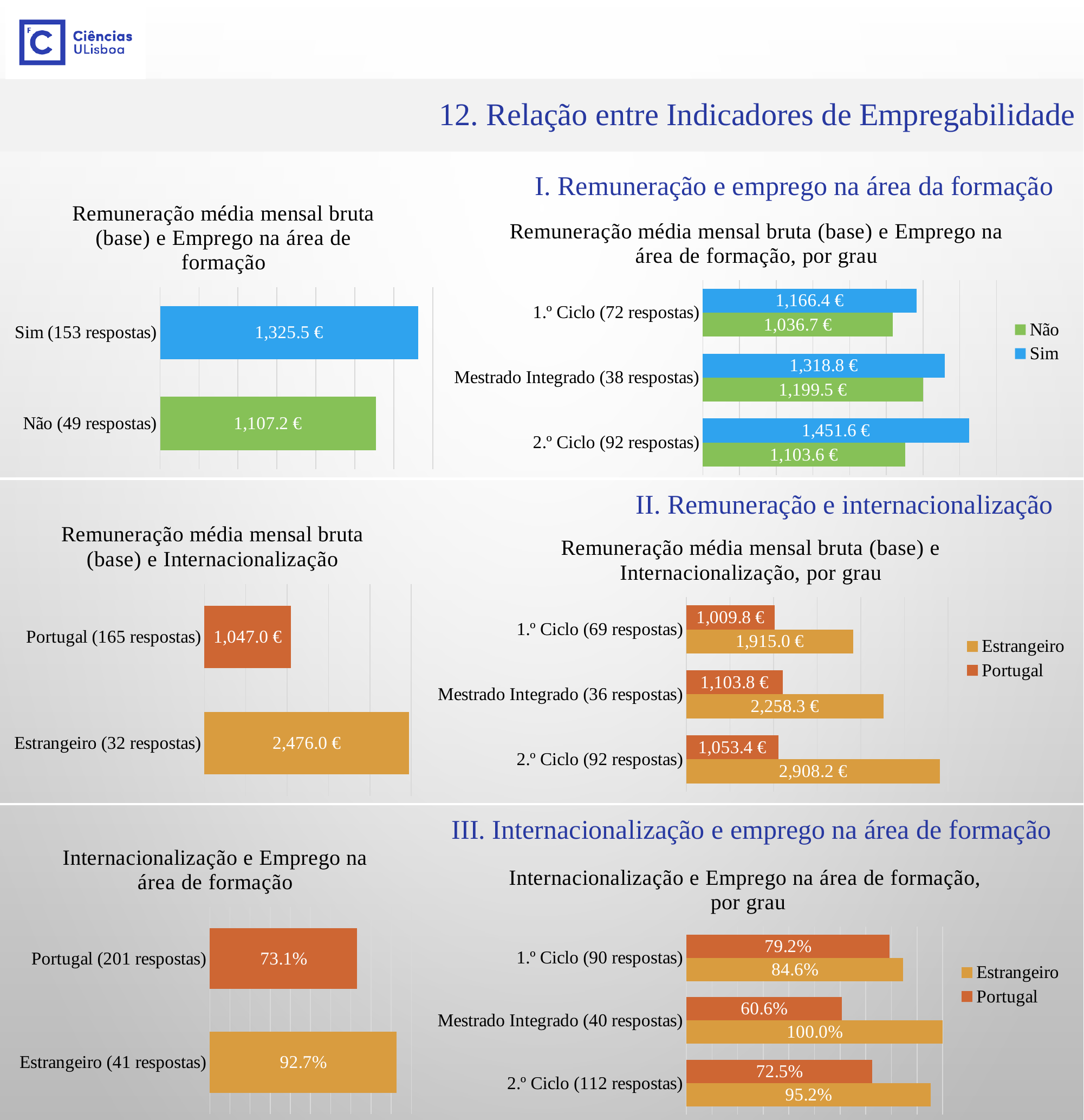
In the top-right chart 'Remuneração média mensal bruta (base) e Emprego na área de formação, por grau', what is the 'Sim' value for '2.º Ciclo (92 respostas)'? 1,451.6 € In the bottom-right chart 'Internacionalização e Emprego na área de formação, por grau', what is the 'Portugal' value for 'Mestrado Integrado (40 respostas)'? 60.6% In the middle-right chart 'Remuneração média mensal bruta (base) e Internacionalização, por grau', what is the 'Estrangeiro' value for 'Mestrado Integrado (36 respostas)'? 2,258.3 € In the bottom-left chart 'Internacionalização e Emprego na área de formação', what is the value for 'Portugal (201 respostas)'? 73.1% In the middle-right chart 'Remuneração média mensal bruta (base) e Internacionalização, por grau', which degree has the highest 'Estrangeiro' value? 2.º Ciclo (92 respostas) In the top-left chart 'Remuneração média mensal bruta (base) e Emprego na área de formação', what is the difference between the 'Sim' and 'Não' values? 218.3 € How many series does the legend list in the top-right chart 'Remuneração média mensal bruta (base) e Emprego na área de formação, por grau'? 2 In the top-left chart 'Remuneração média mensal bruta (base) e Emprego na área de formação', what is the value for 'Sim (153 respostas)'? 1,325.5 € In the middle-left chart 'Remuneração média mensal bruta (base) e Internacionalização', what is the value for 'Estrangeiro (32 respostas)'? 2,476.0 € What type of chart is the bottom-left chart 'Internacionalização e Emprego na área de formação'? Bar chart In the bottom-right chart 'Internacionalização e Emprego na área de formação, por grau', which is larger for '1.º Ciclo (90 respostas)': the 'Estrangeiro' value or the 'Portugal' value? Estrangeiro In the top-right chart 'Remuneração média mensal bruta (base) e Emprego na área de formação, por grau', which degree has the lowest 'Não' value? 1.º Ciclo (72 respostas)